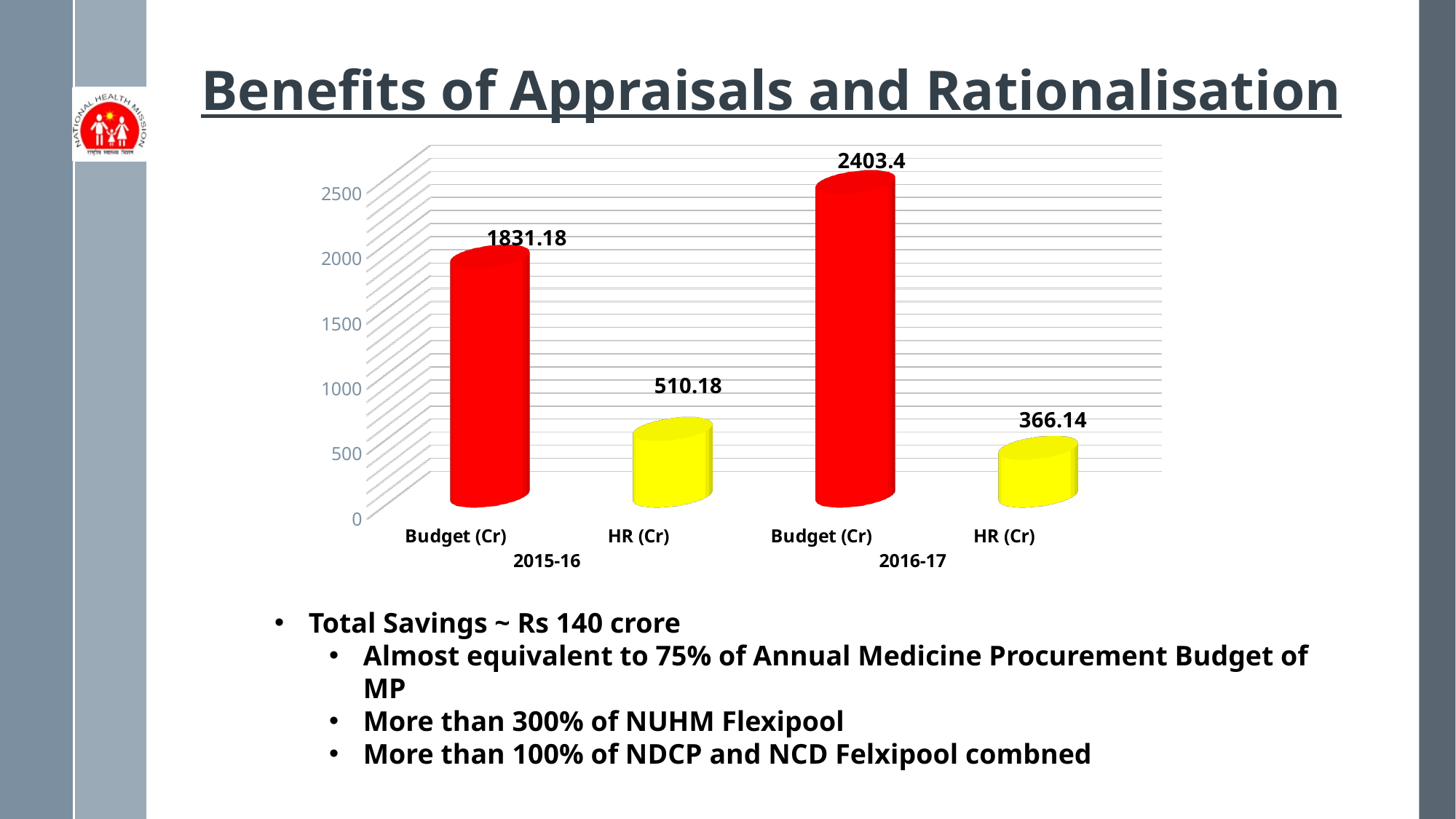
How many bars are plotted in the chart? 4 What is the value of Budget (Cr) for 2016-17? 2403.4 What is the value of HR (Cr) for 2016-17? 366.14 Is the value for Budget (Cr) 2015-16 greater or less than 2000? less Which is larger, HR (Cr) for 2015-16 or HR (Cr) for 2016-17? HR (Cr) for 2015-16 What type of chart is shown on the slide? Bar chart By how much did HR (Cr) fall from 2015-16 to 2016-17? 144.04 What is the value of Budget (Cr) for 2015-16? 1831.18 Which bar has the lowest value? HR (Cr) 2016-17 What is the value of HR (Cr) for 2015-16? 510.18 Which bar has the highest value? Budget (Cr) 2016-17 What is the difference between Budget (Cr) for 2016-17 and Budget (Cr) for 2015-16? 572.22